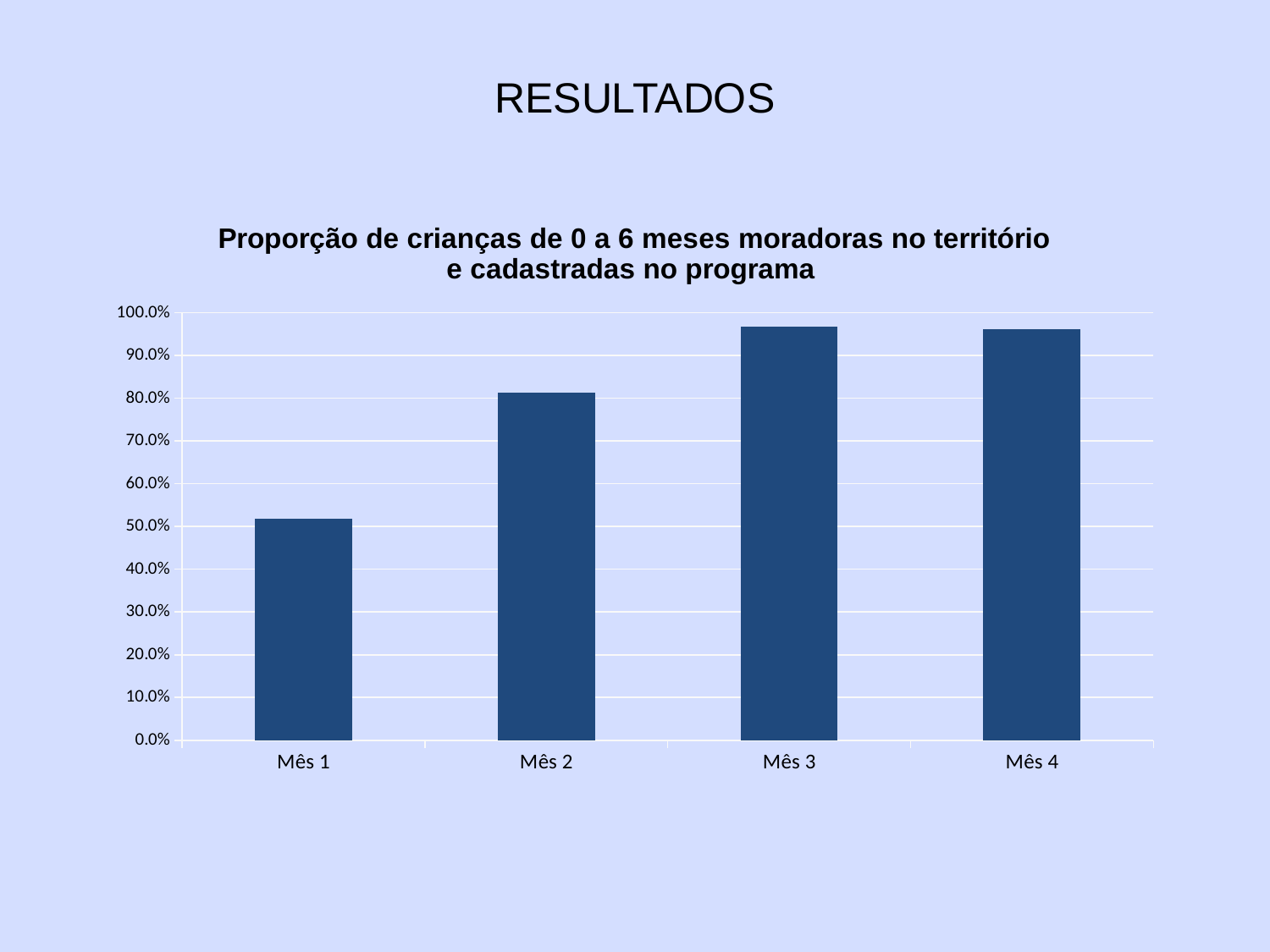
Do the values generally rise or fall from Mês 1 to Mês 3? rise Is the value for Mês 2 greater or less than 80.0%? greater Is the value for Mês 2 greater or less than 90.0%? less Which is larger, the value for Mês 1 or the value for Mês 2? Mês 2 Is the value for Mês 1 greater or less than 60.0%? less What is the title of the chart? Proporção de crianças de 0 a 6 meses moradoras no território e cadastradas no programa Which month has the lowest proportion in the chart? Mês 1 What kind of chart is shown on the slide? bar chart How many categories (months) are shown on the x axis of the chart? 4